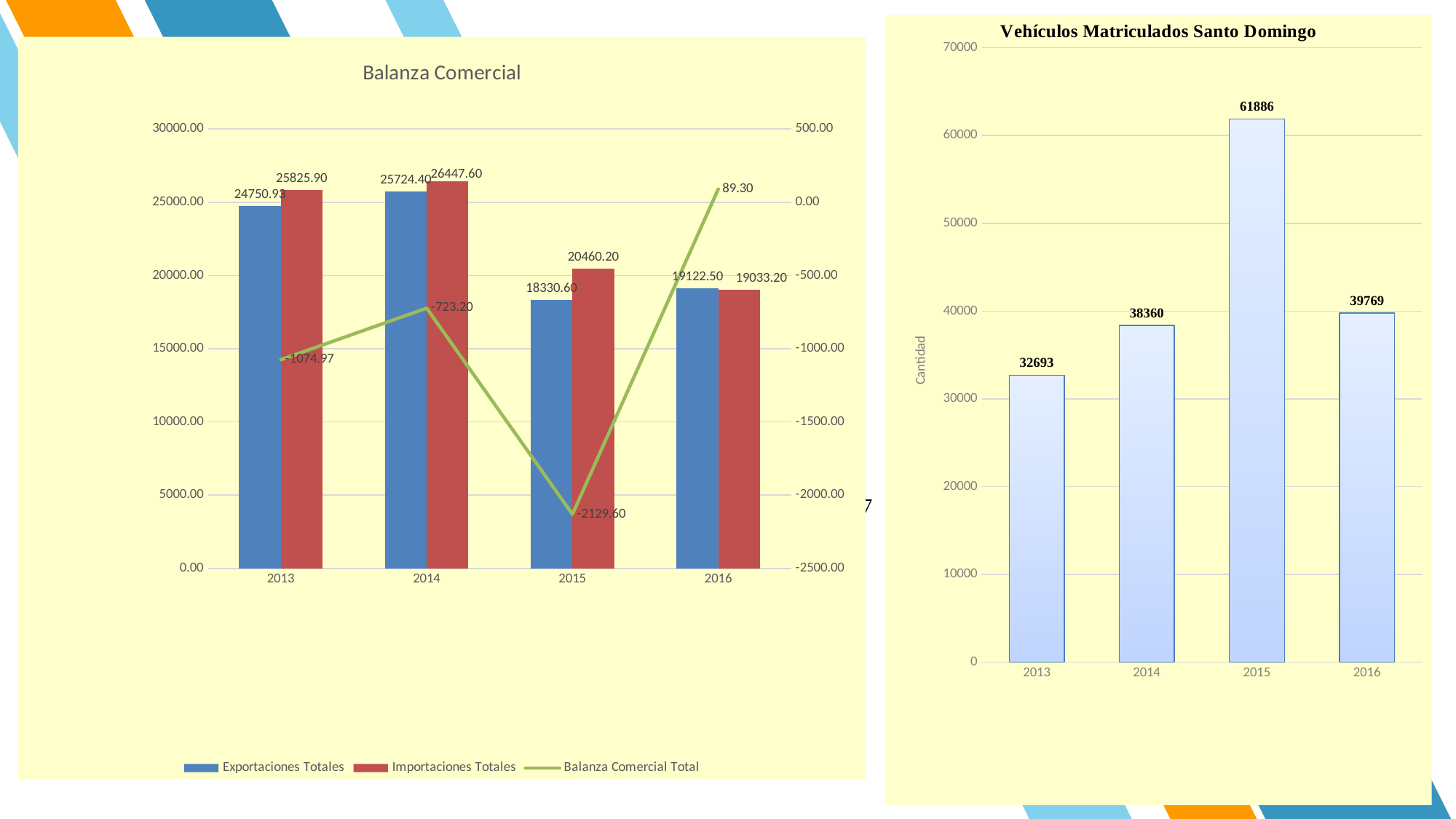
In the Vehículos Matriculados Santo Domingo chart, which year has the lowest value? 2013 In the Balanza Comercial chart, what is the Balanza Comercial Total value for 2016? 89.30 In the Vehículos Matriculados Santo Domingo chart, how many vehicles were registered in 2015? 61886 In the Balanza Comercial chart, which is larger in 2016: Exportaciones Totales or Importaciones Totales? Exportaciones Totales In the Balanza Comercial chart, which year has the lowest Balanza Comercial Total? 2015 In the Balanza Comercial chart, what is the value of Exportaciones Totales for 2014? 25724.40 In the Balanza Comercial chart, what is the difference between Importaciones Totales and Exportaciones Totales in 2013? 1074.97 What kind of chart is the Vehículos Matriculados Santo Domingo chart? Bar chart In the Balanza Comercial chart, what is the value of Importaciones Totales for 2015? 20460.20 In the Vehículos Matriculados Santo Domingo chart, what is the difference between the 2016 and 2014 values? 1409 In the Balanza Comercial chart, which year has the highest Importaciones Totales? 2014 How many series does the legend of the Balanza Comercial chart list? 3